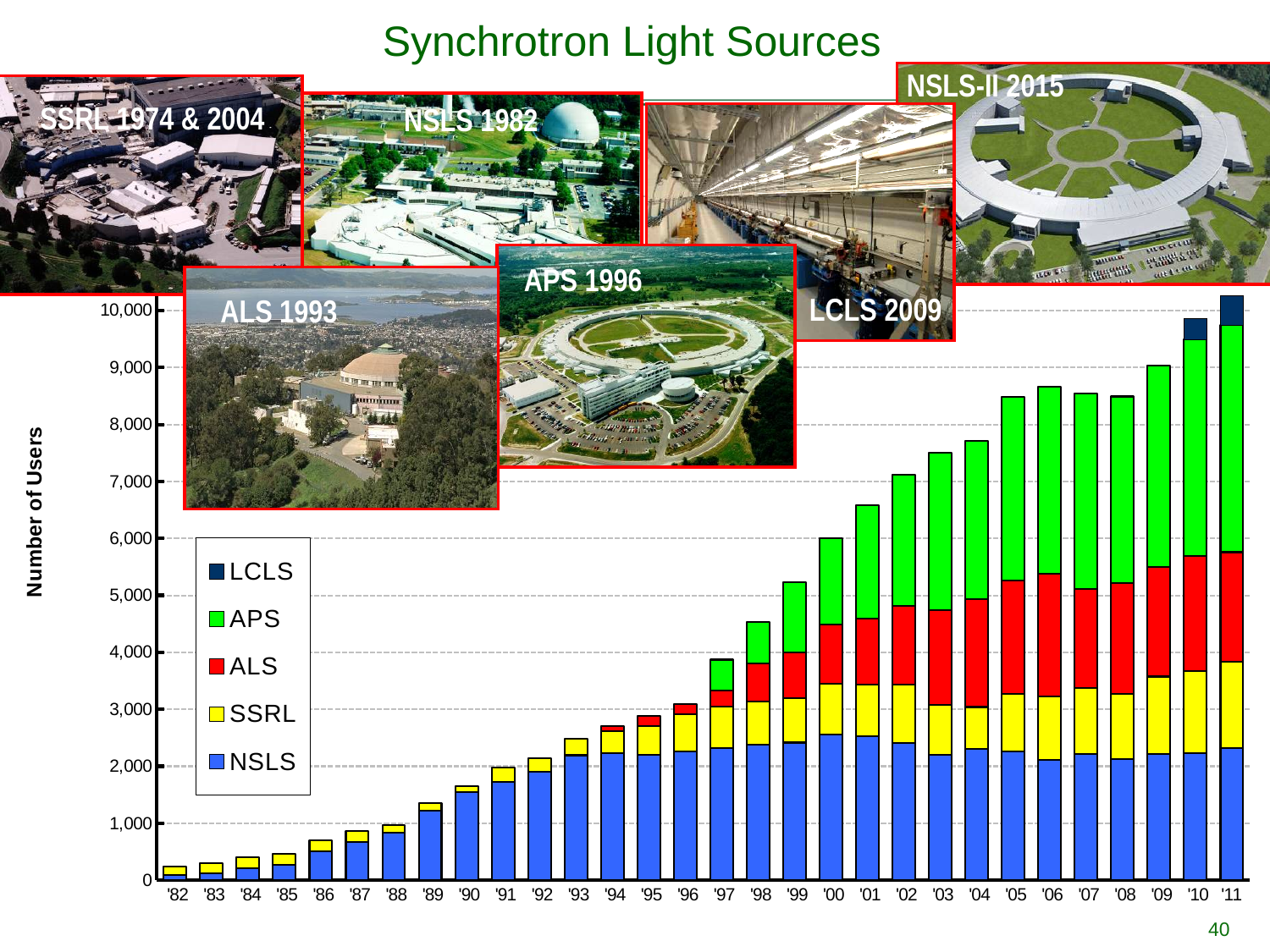
Is the NSLS value in '11 greater or less than 2,000? greater What kind of chart is shown on the slide? Stacked bar chart Does the total number of users generally rise or fall from '82 to '11? rise How many years are shown along the x axis? 30 What is the title of the y axis? Number of Users Which year has the lowest total number of users? '82 How many series does the legend list? 5 Is the total number of users in '11 greater or less than 9,000? greater Is the total number of users in '82 greater or less than 1,000? less Which year has a higher total number of users, '08 or '09? '09 Which year has the highest total number of users? '11